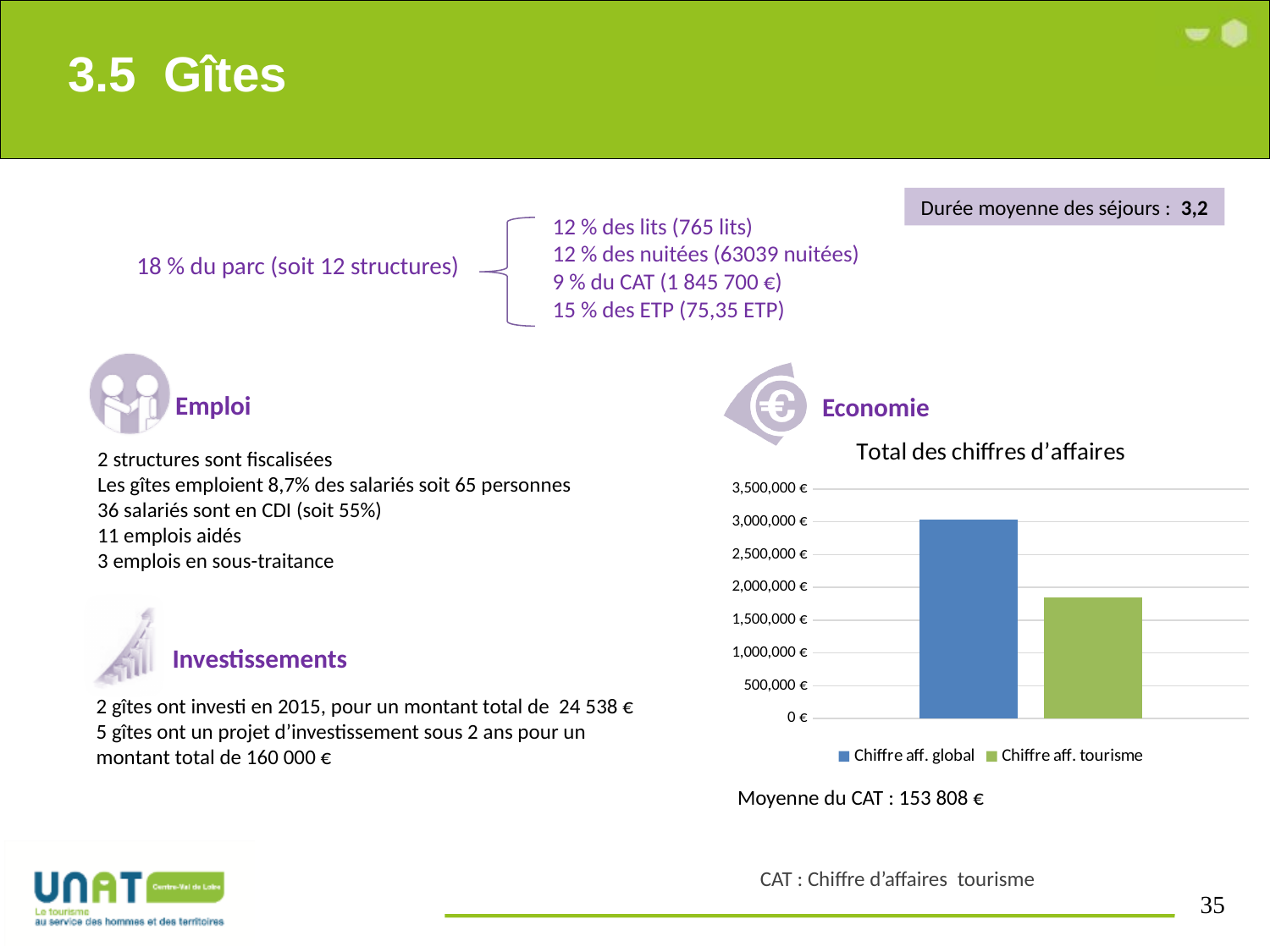
How many series does the legend of the 'Total des chiffres d'affaires' chart list? 2 Is the bar for 'Chiffre aff. global' larger or smaller than the bar for 'Chiffre aff. tourisme'? larger Is the value for 'Chiffre aff. tourisme' greater or less than 2,000,000 €? less What kind of chart is shown under 'Total des chiffres d'affaires'? bar chart What is the title of the chart on the slide? Total des chiffres d'affaires Which series has the shorter bar in the 'Total des chiffres d'affaires' chart? Chiffre aff. tourisme Is the value for 'Chiffre aff. global' greater or less than 2,500,000 €? greater Is the value for 'Chiffre aff. tourisme' greater or less than 1,500,000 €? greater Which series has the taller bar in the 'Total des chiffres d'affaires' chart? Chiffre aff. global What colour is the bar for 'Chiffre aff. tourisme' in the chart? green How many bars are plotted in the 'Total des chiffres d'affaires' chart? 2